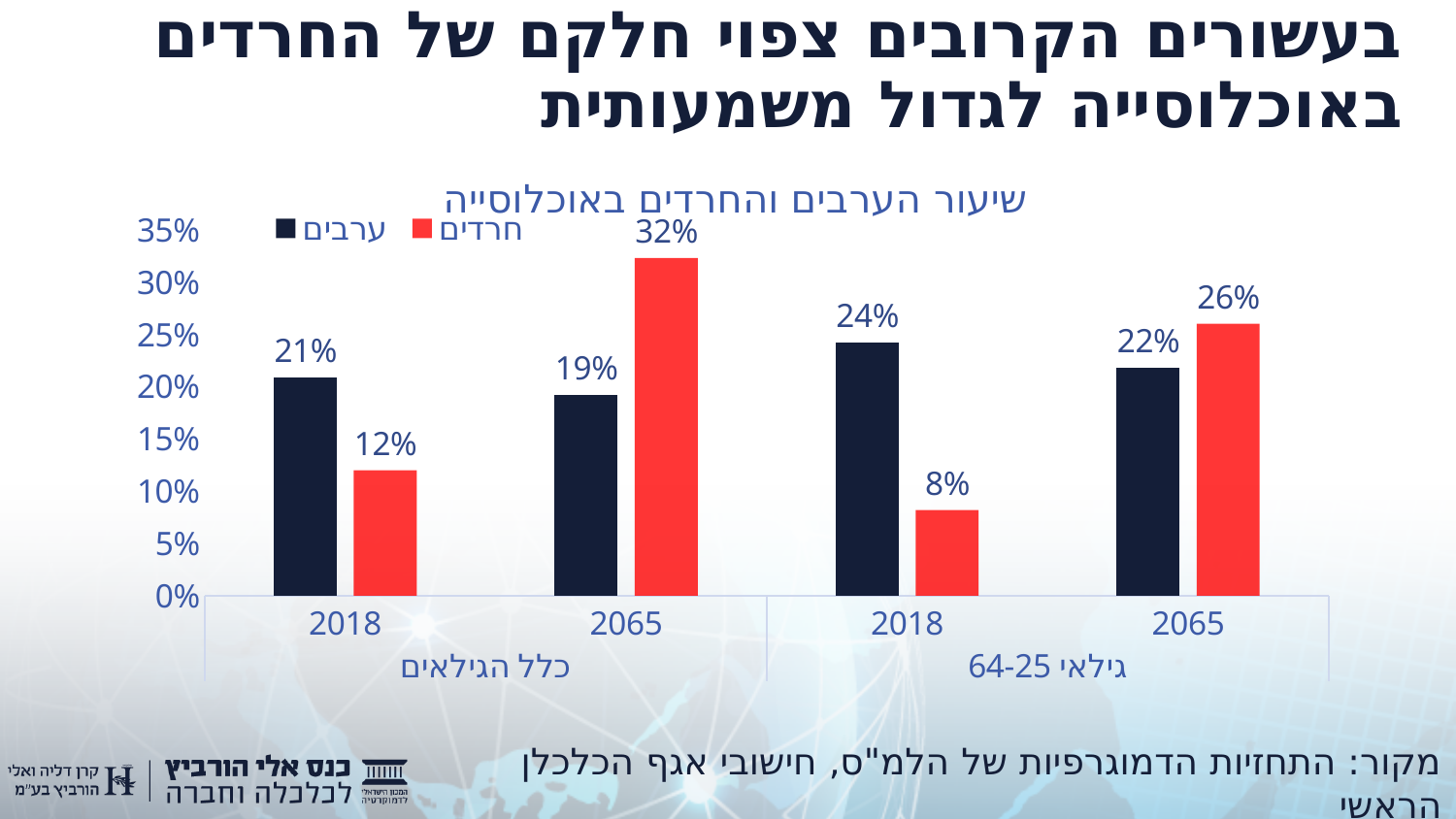
What kind of chart is shown on the slide? Bar chart In 2065 under גילאי 25-64 (ages 25-64), which series has the larger value, ערבים (Arabs) or חרדים (Haredim)? חרדים (Haredim) What is the value for ערבים (Arabs) in 2065 under גילאי 25-64 (ages 25-64)? 22% What is the value for ערבים (Arabs) in 2018 under כלל הגילאים (all ages)? 21% How many series does the legend list? 2 What is the value for חרדים (Haredim) in 2018 under גילאי 25-64 (ages 25-64)? 8% Does the ערבים (Arabs) value rise or fall from 2018 to 2065 under כלל הגילאים (all ages)? Fall Which bar has the highest value in the chart? חרדים (Haredim), 2065, כלל הגילאים (all ages) What is the value for חרדים (Haredim) in 2065 under כלל הגילאים (all ages)? 32% What is the difference between the חרדים (Haredim) value in 2065 and in 2018 under כלל הגילאים (all ages)? 20% What colour are the bars for חרדים (Haredim)? Red Which bar has the lowest value in the chart? חרדים (Haredim), 2018, גילאי 25-64 (ages 25-64)